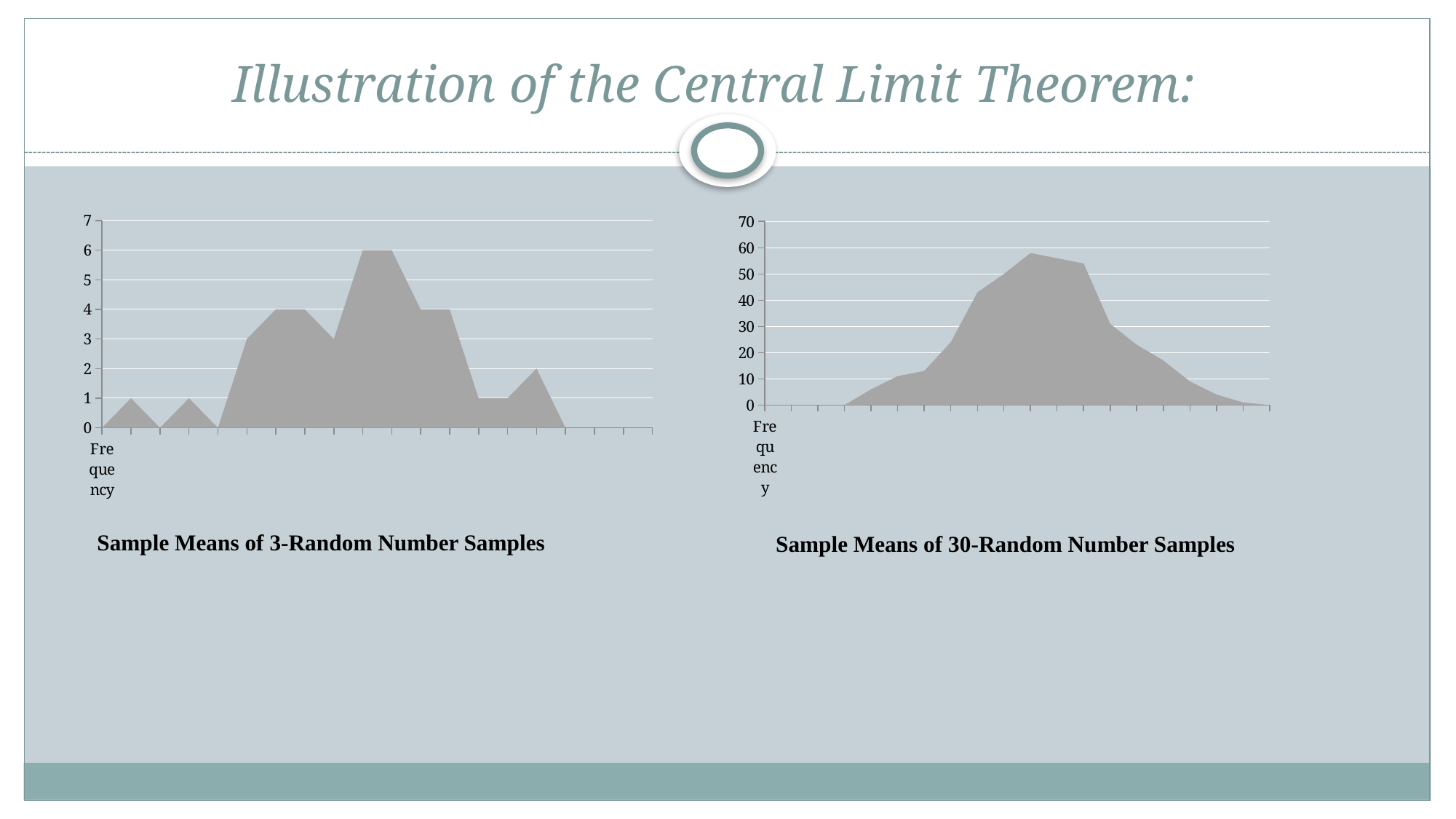
What kind of chart is the right chart, 'Sample Means of 30-Random Number Samples'? area chart In the left chart, 'Sample Means of 3-Random Number Samples', is the peak frequency greater or less than 5? greater What kind of chart is the left chart, 'Sample Means of 3-Random Number Samples'? area chart What is the highest frequency reached in the left chart, 'Sample Means of 3-Random Number Samples'? 6 In the right chart, 'Sample Means of 30-Random Number Samples', is the peak frequency greater or less than 50? greater What is the highest value shown on the y axis of the right chart? 70 In the right chart, 'Sample Means of 30-Random Number Samples', do the values rise or fall from the peak toward the right end of the x axis? fall In the left chart, 'Sample Means of 3-Random Number Samples', is the lowest frequency at the right end of the x axis greater or less than 1? less Which chart reaches a higher peak frequency, the left chart (3-Random Number Samples) or the right chart (30-Random Number Samples)? the right chart (30-Random Number Samples)